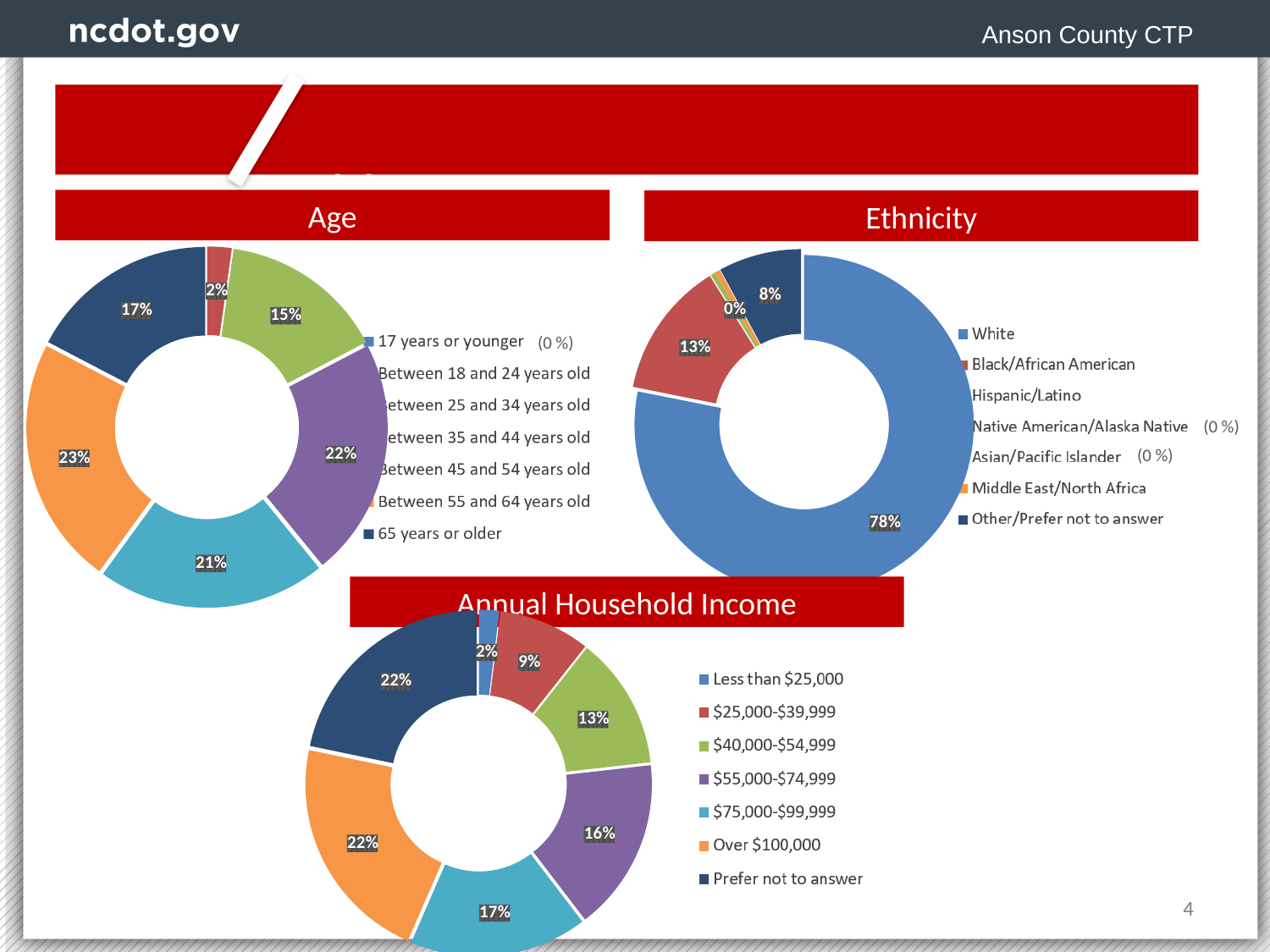
In the Annual Household Income chart, what percentage of respondents earn $55,000-$74,999? 16% In the Age chart, which age group has the largest share? Between 55 and 64 years old In the Age chart, what percentage of respondents are between 55 and 64 years old? 23% What type of chart is the Annual Household Income chart? Doughnut chart In the Annual Household Income chart, what is the difference between the share for Over $100,000 and the share for $25,000-$39,999? 13% In the Annual Household Income chart, which income category has the smallest share? Less than $25,000 In the Ethnicity chart, what percentage of respondents are White? 78% In the Age chart, what is the difference between the share for 35 to 44 years old and the share for 25 to 34 years old? 7% In the Ethnicity chart, which is larger: the share for Black/African American or the share for Other/Prefer not to answer? Black/African American In the Ethnicity chart, what percentage of respondents are Black/African American? 13% How many entries does the legend of the Ethnicity chart list? 7 In the Age chart, what percentage of respondents are 65 years or older? 17%